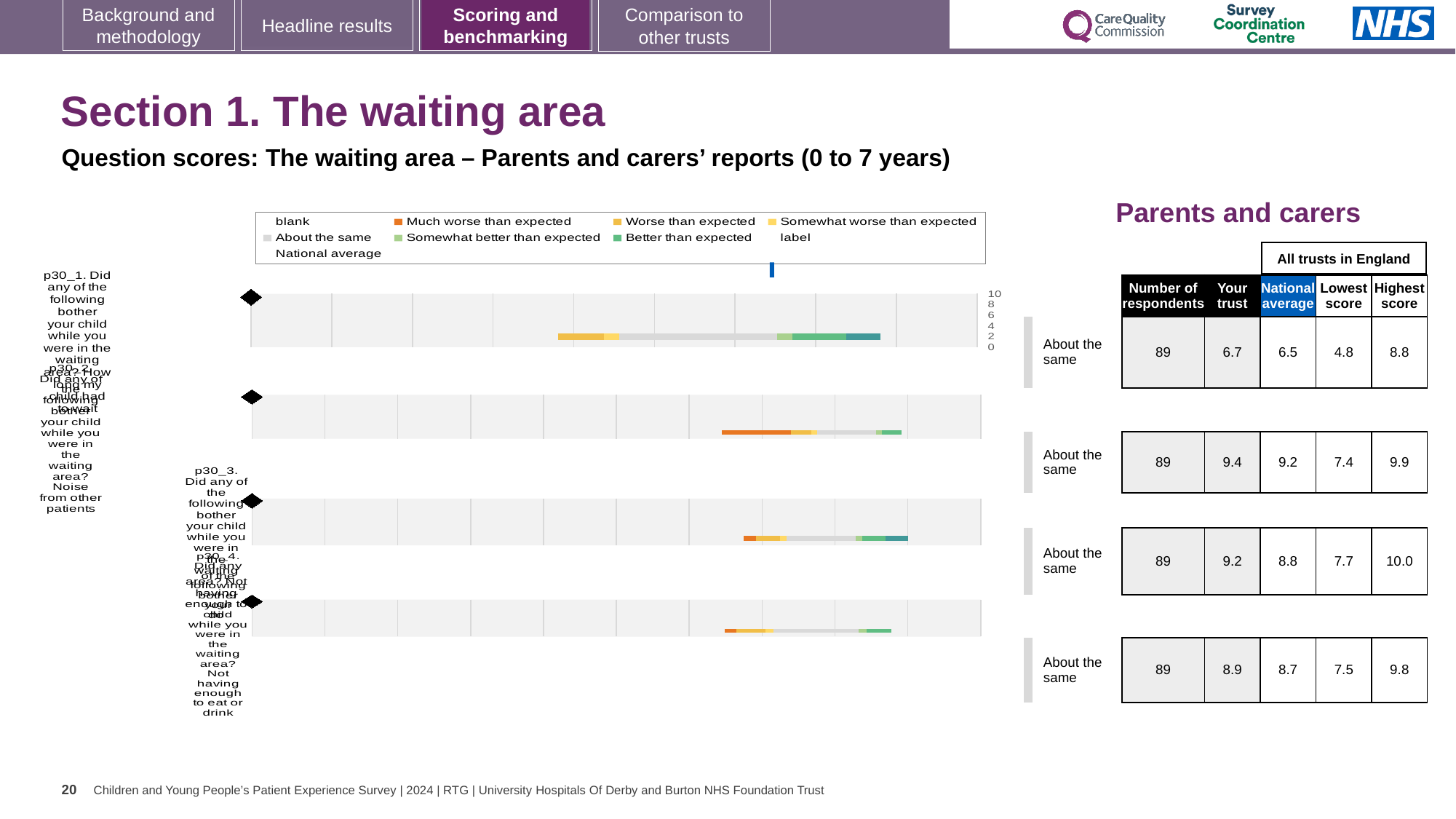
Which question has the lowest 'Your trust' score in the table beside the charts? p30_1 In the table beside the charts, what is the number of respondents for p30_2? 89 In the legend, what colour represents 'About the same'? light grey How many question charts (p30_1 to p30_4) are shown on the slide? 4 Which question has the highest 'Your trust' score in the table beside the charts? p30_2 For p30_3, which is larger: the 'Your trust' score or the national average? Your trust In the legend, what colour represents 'Much worse than expected'? orange For p30_1, what is the difference between the highest score (8.8) and the lowest score (4.8) across all trusts in England? 4.0 In the table beside the charts, what is the 'Your trust' score for p30_1 (Did any of the following bother your child while you were in the waiting area? How long my child had to wait)? 6.7 How many entries does the legend above the charts list? 9 In the table beside the charts, what is the national average for p30_4 (Not having enough to eat or drink)? 8.7 What kind of chart is used for the question scores on this slide? bar chart